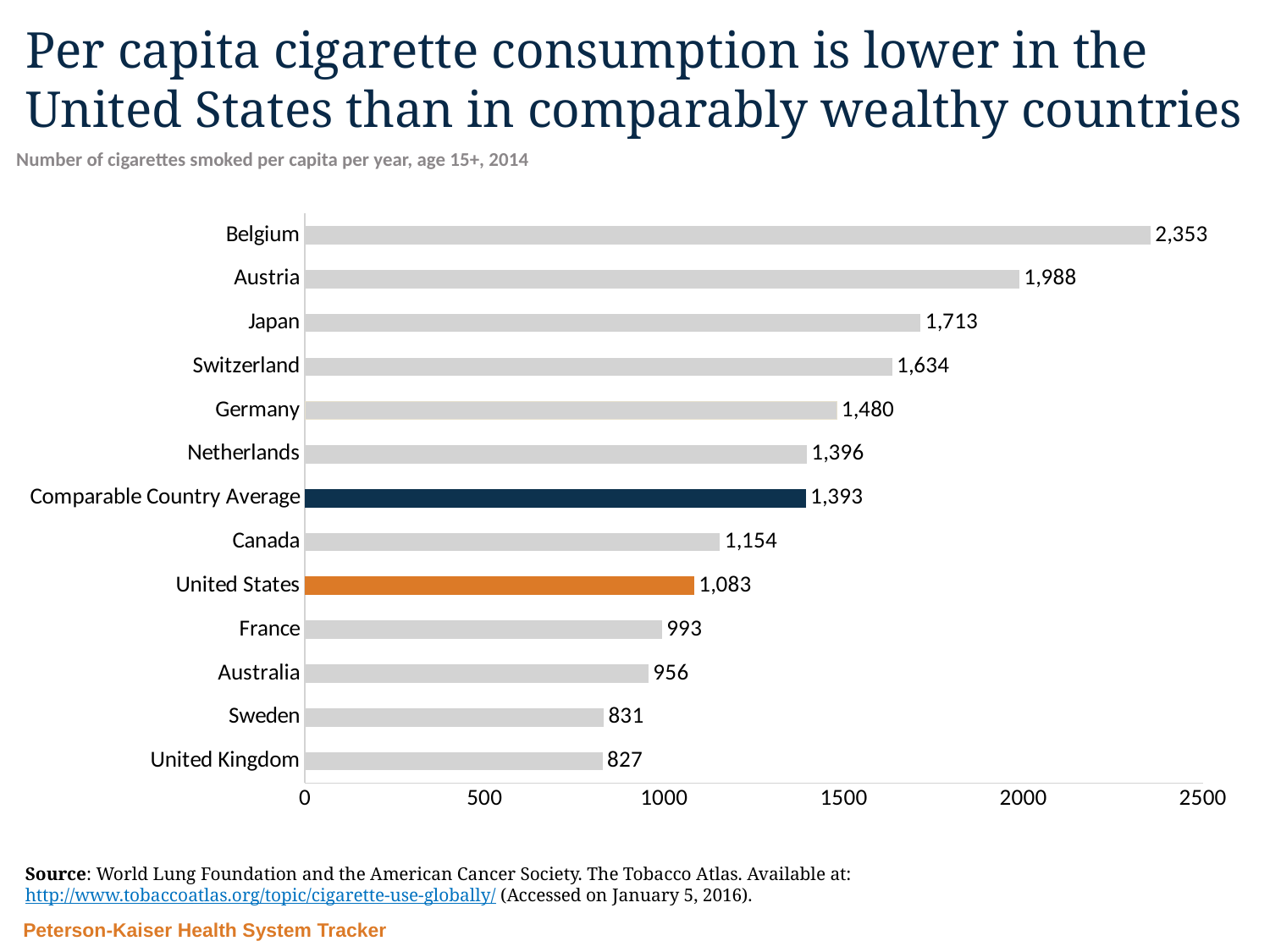
Which country has the highest per capita cigarette consumption on the chart? Belgium What kind of chart is shown on the slide? Bar chart Which bar is coloured orange on the chart? United States What is the difference between the Comparable Country Average and the United States value? 310 What is the value shown for the Comparable Country Average? 1,393 Which has a higher value, Canada or France? Canada How many bars are shown on the chart? 13 Which country has the lowest per capita cigarette consumption on the chart? United Kingdom Is the value for Germany greater or less than 1500? less What is the difference between the values for Austria and Japan? 275 What is the value shown for the United States? 1,083 What is the number of cigarettes smoked per capita per year in Belgium? 2,353